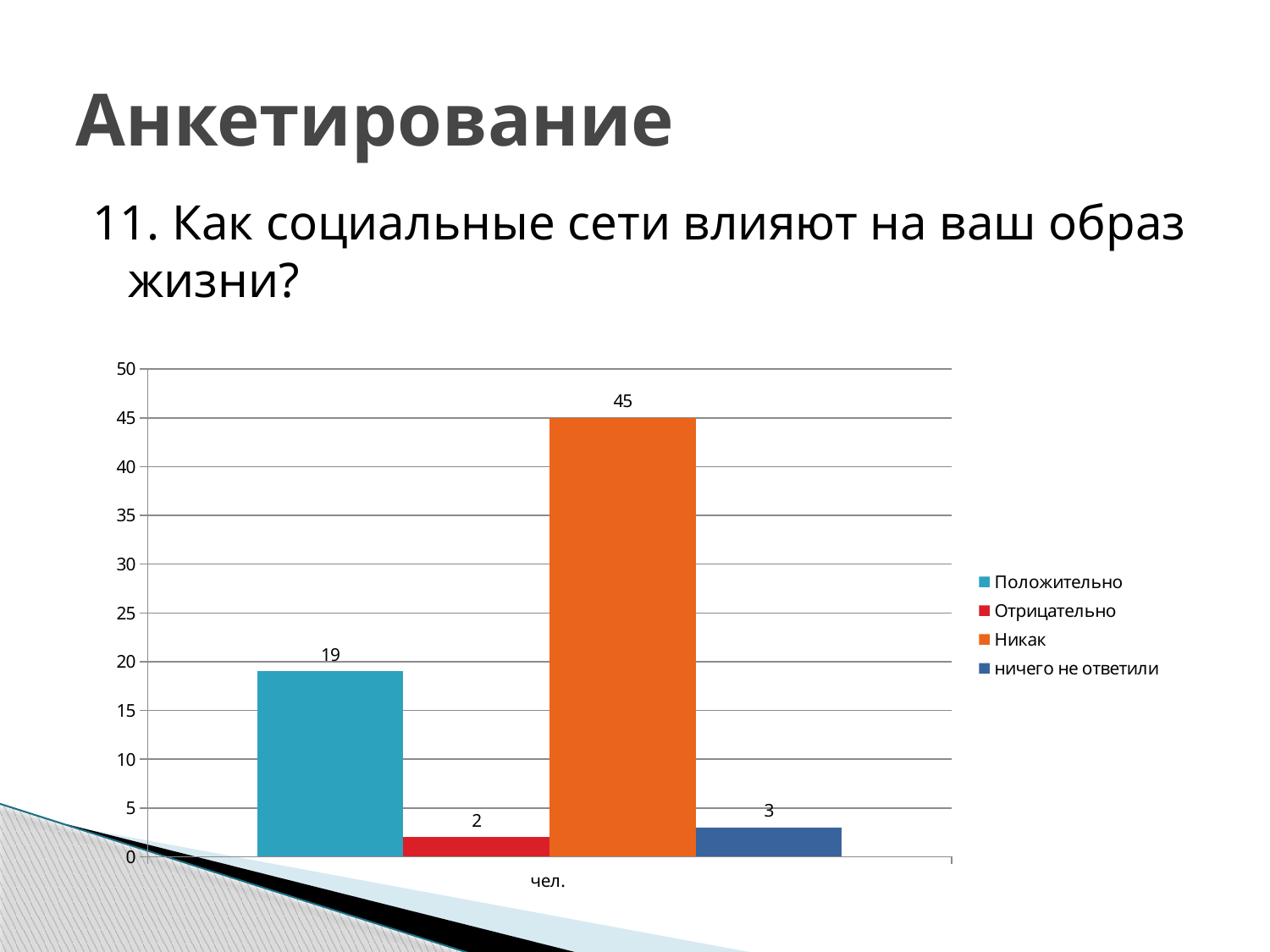
What is the value for Положительно? 19 What is the value for Отрицательно? 2 Which series has the highest value? Никак What kind of chart is shown on the slide? bar chart What is the value for Никак? 45 Which series has the lowest value? Отрицательно How many series does the legend list? 4 Which is larger, the value for Положительно or the value for ничего не ответили? Положительно What is the label on the x axis of the chart? чел. Is the value for Никак greater or less than 40? greater What is the difference between the values for Никак and Положительно? 26 What is the value for ничего не ответили? 3